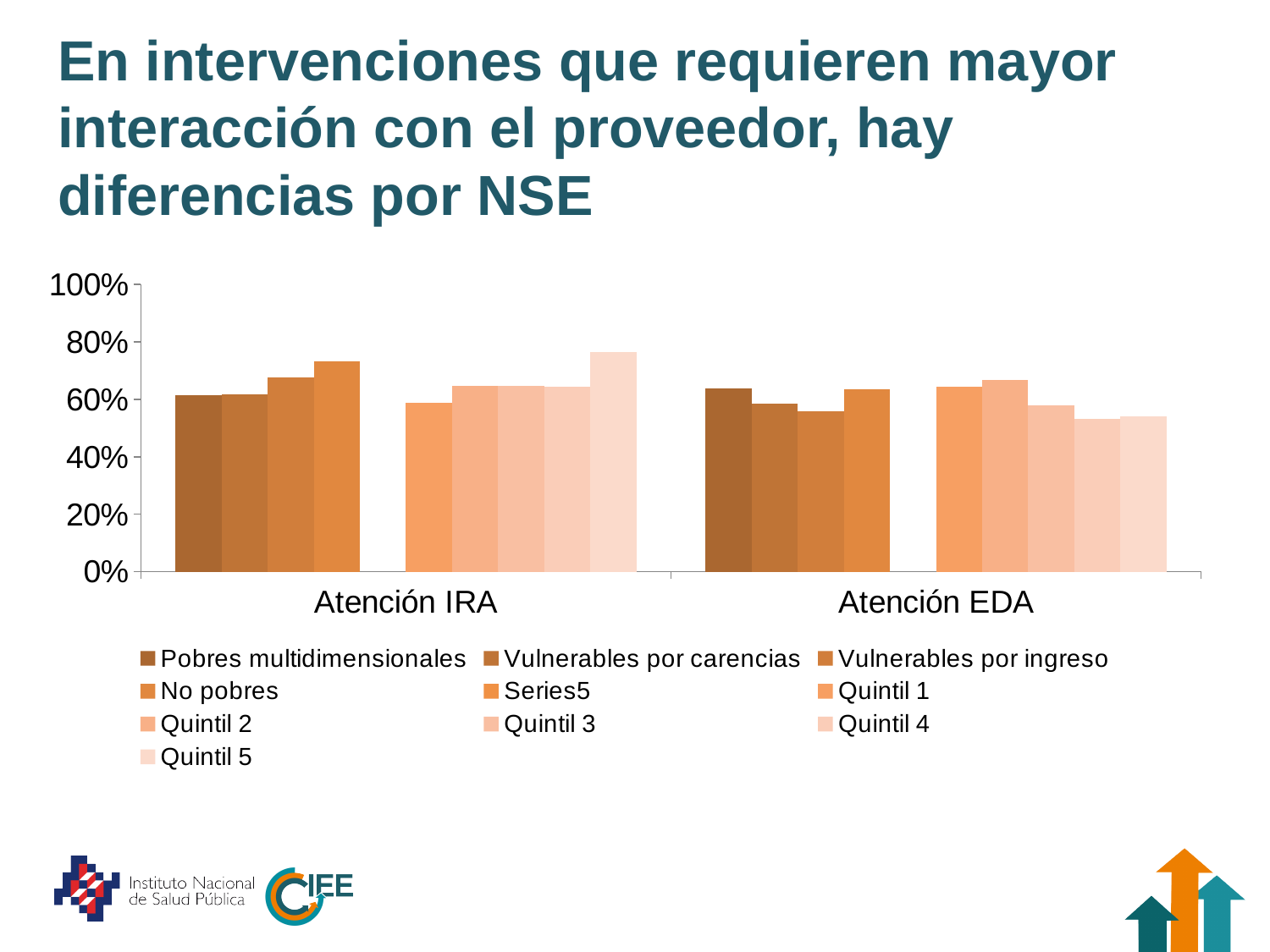
Is the value for No pobres in Atención IRA greater or less than 60%? greater What kind of chart is shown on the slide? bar chart Is the value for Quintil 4 in Atención EDA greater or less than 60%? less In Atención IRA, which is larger: the value for Quintil 5 or the value for Quintil 1? Quintil 5 In Atención EDA, which is larger: the value for Quintil 2 or the value for Quintil 4? Quintil 2 How many categories are shown on the x axis of the chart? 2 Which series has the highest value in Atención IRA? Quintil 5 Is the value for Quintil 5 in Atención IRA greater or less than 80%? less How many series does the chart's legend list? 10 In Atención EDA, which is larger: the value for Pobres multidimensionales or the value for Vulnerables por ingreso? Pobres multidimensionales What are the two categories on the x axis of the chart? Atención IRA and Atención EDA